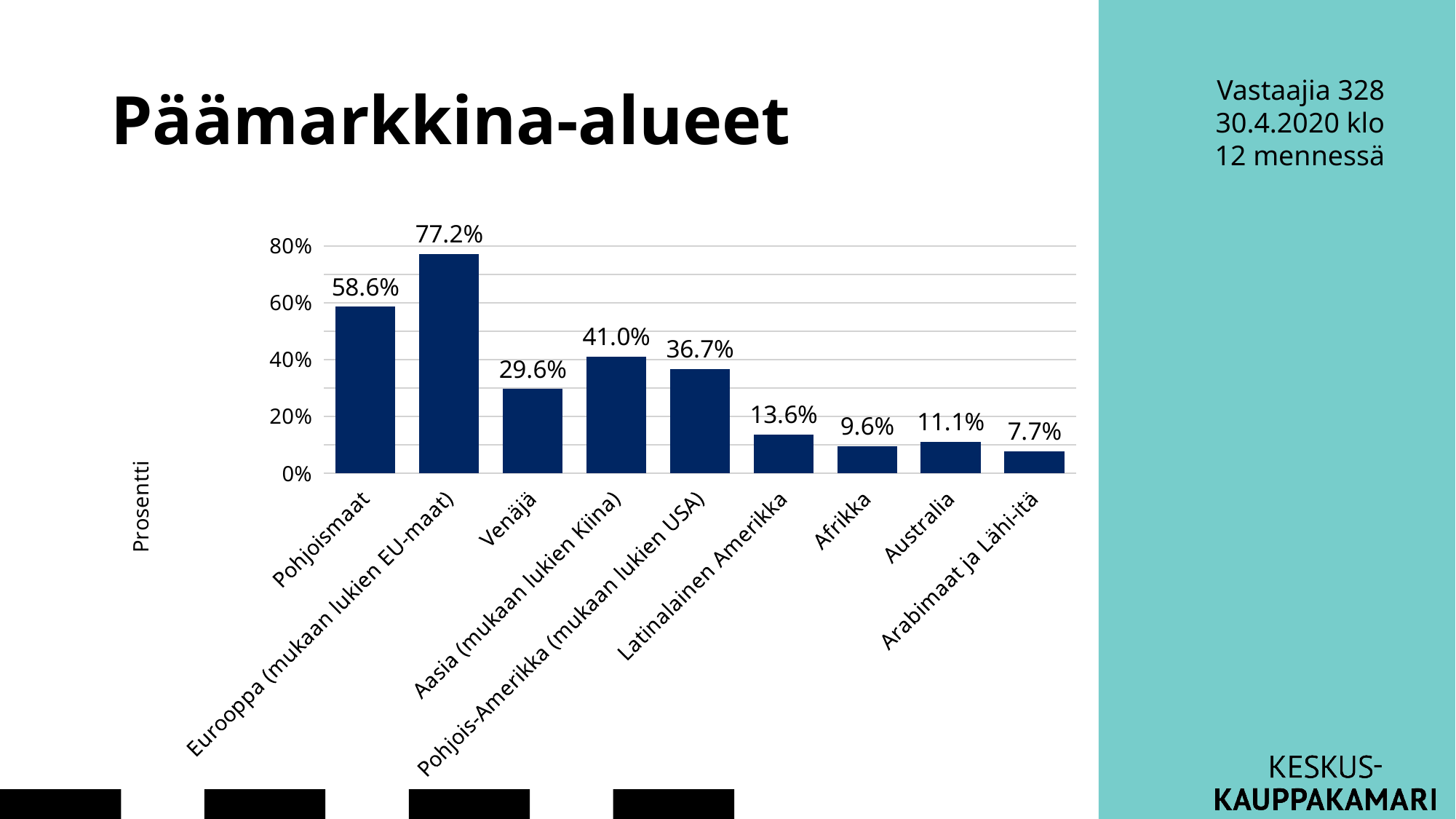
What is the value for Venäjä? 29.6% What is the difference between the values for Aasia (mukaan lukien Kiina) and Pohjois-Amerikka (mukaan lukien USA)? 4.3% Which category has the highest value? Eurooppa (mukaan lukien EU-maat) What is the value for Pohjoismaat? 58.6% How many categories are shown on the x axis? 9 What is the value for Eurooppa (mukaan lukien EU-maat)? 77.2% What is the label of the y axis? Prosentti Which is larger, the value for Afrikka or the value for Australia? Australia Which category has the lowest value? Arabimaat ja Lähi-itä What is the title of the slide? Päämarkkina-alueet What kind of chart is shown on the slide? Bar chart What is the value for Latinalainen Amerikka? 13.6%